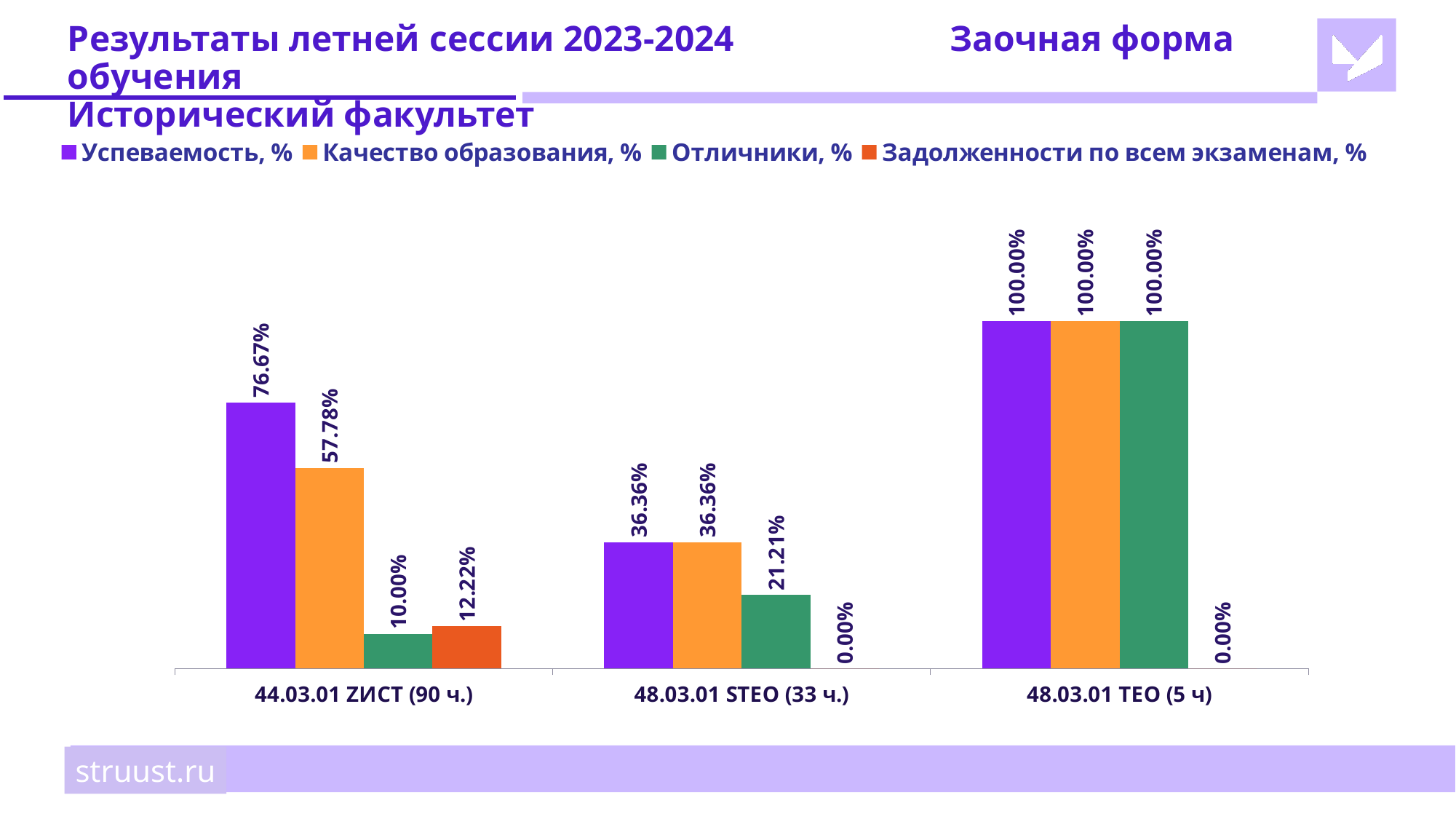
How many categories are shown on the x axis? 3 What is the value of Успеваемость, % for 44.03.01 ZИСТ (90 ч.)? 76.67% Which category has the lowest value of Отличники, %? 44.03.01 ZИСТ (90 ч.) Which is larger for 44.03.01 ZИСТ (90 ч.): Отличники, % or Задолженности по всем экзаменам, %? Задолженности по всем экзаменам, % What is the value of Задолженности по всем экзаменам, % for 44.03.01 ZИСТ (90 ч.)? 12.22% What is the value of Отличники, % for 48.03.01 STEO (33 ч.)? 21.21% What kind of chart is shown on the slide? Bar chart What is the value of Качество образования, % for 44.03.01 ZИСТ (90 ч.)? 57.78% What is the value of Отличники, % for 48.03.01 TEO (5 ч)? 100.00% What is the difference between Успеваемость, % and Качество образования, % for 44.03.01 ZИСТ (90 ч.)? 18.89% How many series does the legend list? 4 Which category has the highest value of Успеваемость, %? 48.03.01 TEO (5 ч)